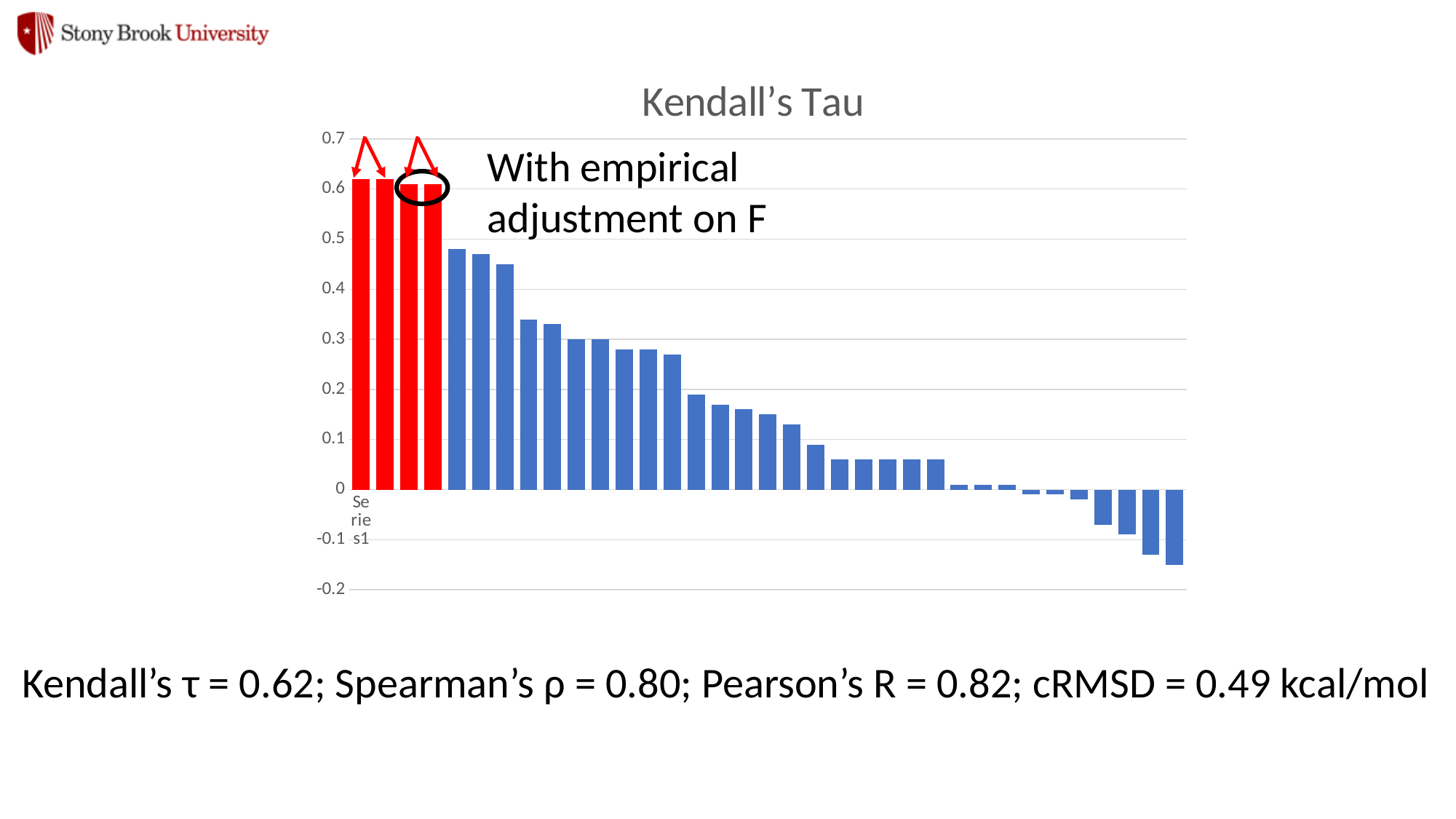
Where on the x axis is the lowest bar located? at the far right Is the value of the leftmost bar greater or less than 0.5? greater Is the value of the rightmost bar greater or less than 0? less Which is larger, the first blue bar or the last blue bar? the first blue bar What colour are the four tallest bars in the chart? red What kind of chart is shown on the slide? bar chart Which is larger, the leftmost bar or the rightmost bar? the leftmost bar What is the title of the chart? Kendall's Tau What is the highest value shown on the y axis? 0.7 Do the bar values rise or fall from left to right along the x axis? fall Is the value of the first blue bar greater or less than 0.4? greater